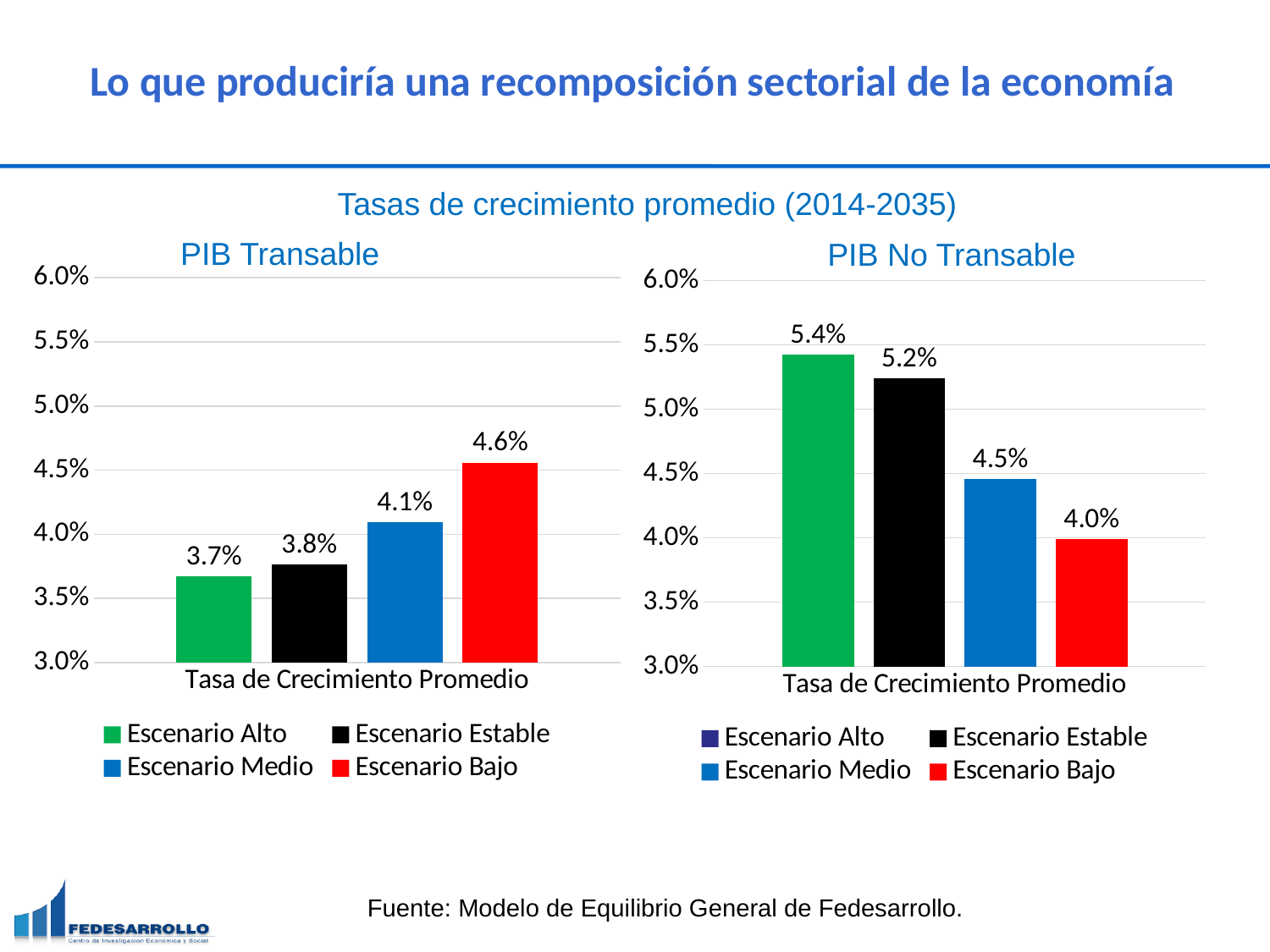
In the PIB No Transable chart, what is the difference between the Escenario Alto and Escenario Bajo values? 1.4% In the PIB Transable chart, which scenario has the highest growth rate? Escenario Bajo In the PIB No Transable chart, what is the value for Escenario Alto? 5.4% In the PIB Transable chart, what is the value for Escenario Bajo? 4.6% What is the title shown above both charts? Tasas de crecimiento promedio (2014-2035) In the PIB No Transable chart, which scenario has the lowest growth rate? Escenario Bajo Which is larger: Escenario Medio in the PIB Transable chart or Escenario Medio in the PIB No Transable chart? PIB No Transable In the PIB Transable chart, what is the value for Escenario Medio? 4.1% How many series does the legend of the PIB Transable chart list? 4 In the PIB No Transable chart, what is the value for Escenario Estable? 5.2% What kind of chart is the PIB No Transable chart? Bar chart In the PIB Transable chart, what is the difference between the Escenario Bajo and Escenario Alto values? 0.9%